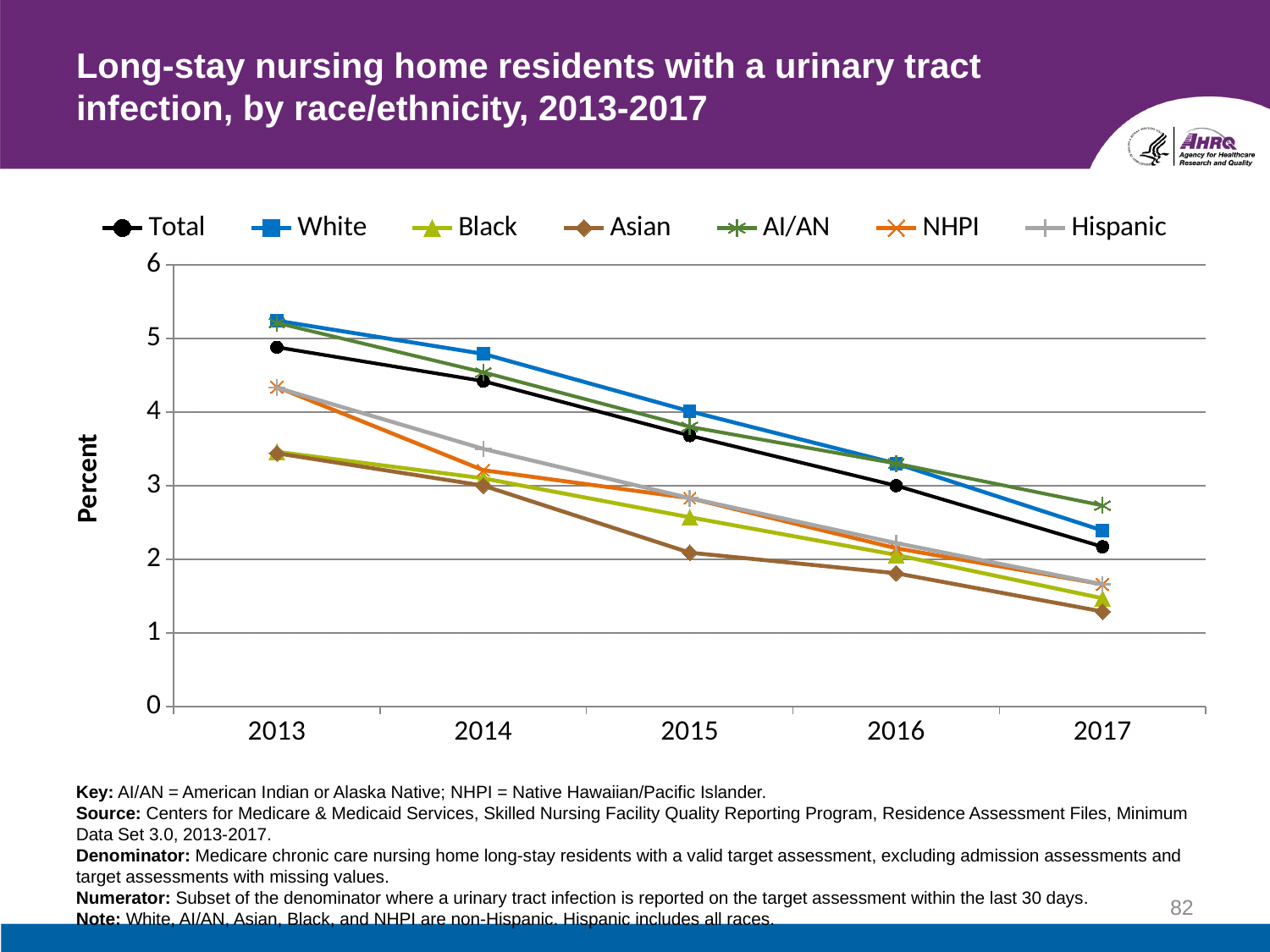
Is the value for White in 2013 greater or less than 5? greater Which group has the highest value in 2017? AI/AN What kind of chart is shown on the slide? Line chart How many years are shown on the x axis? 5 What is the label on the y axis? Percent Is the value for Hispanic in 2014 greater or less than 3? greater Which group has the lowest value in 2015? Asian Does the Total line rise or fall from 2013 to 2017? Fall Is the value for Total in 2014 greater or less than 4? greater In 2014, which is larger, the value for White or the value for Black? White How many series does the legend list? 7